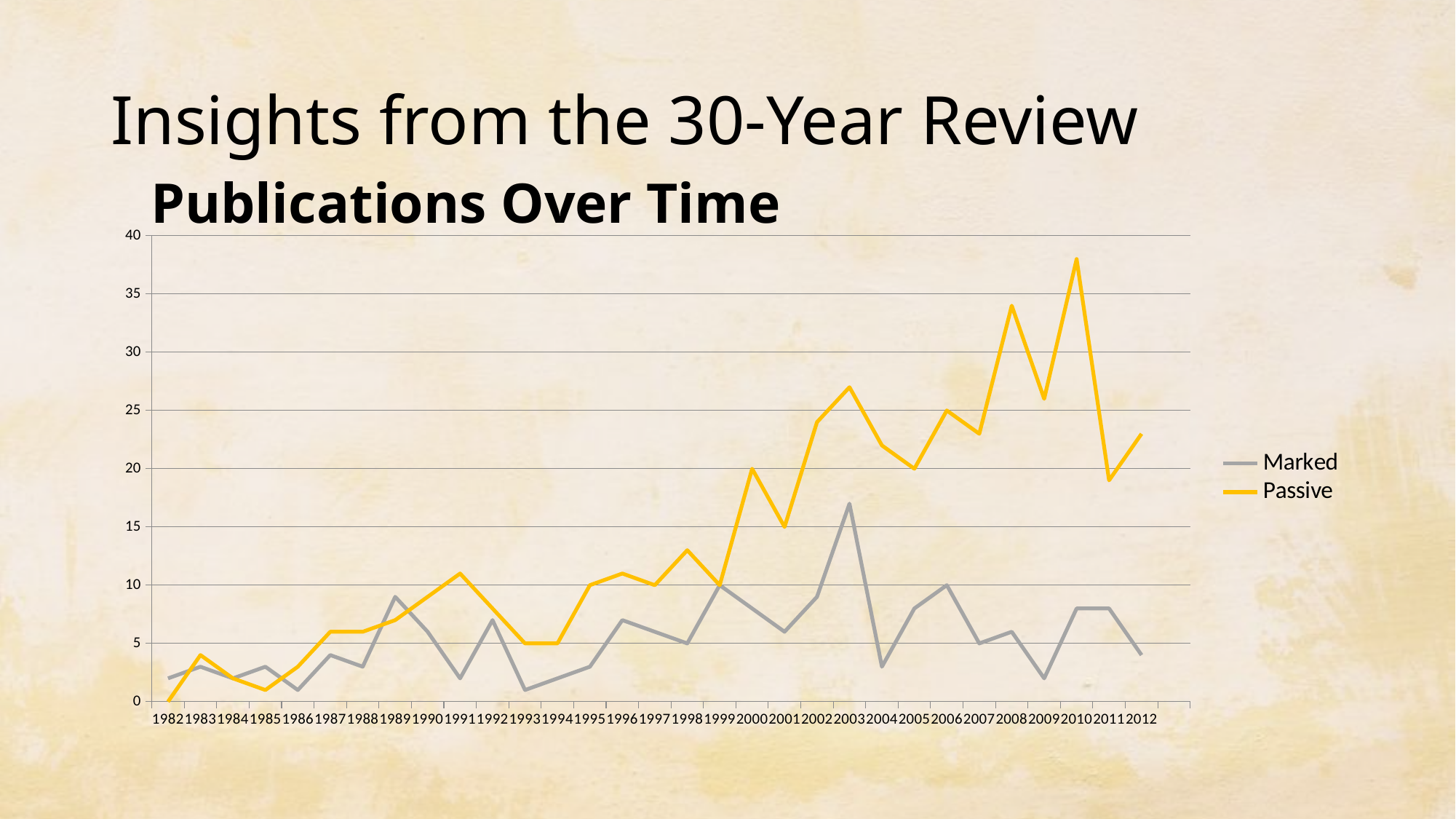
What is the value for Passive in 2000? 20 Is the value for Marked in 2003 greater or less than 15? greater In which year does the Passive series reach its highest value? 2010 How many years are plotted along the x axis? 31 Is the value for Passive in 2010 greater or less than 35? greater Which series has the larger value in 2010, Marked or Passive? Passive What is the title of the chart? Publications Over Time In which year does the Marked series reach its highest value? 2003 What kind of chart is shown on the slide? Line chart How many series does the legend list? 2 Is the value for Passive in 2008 greater or less than 30? greater Overall, do the Passive values rise or fall from 1982 to 2012? Rise